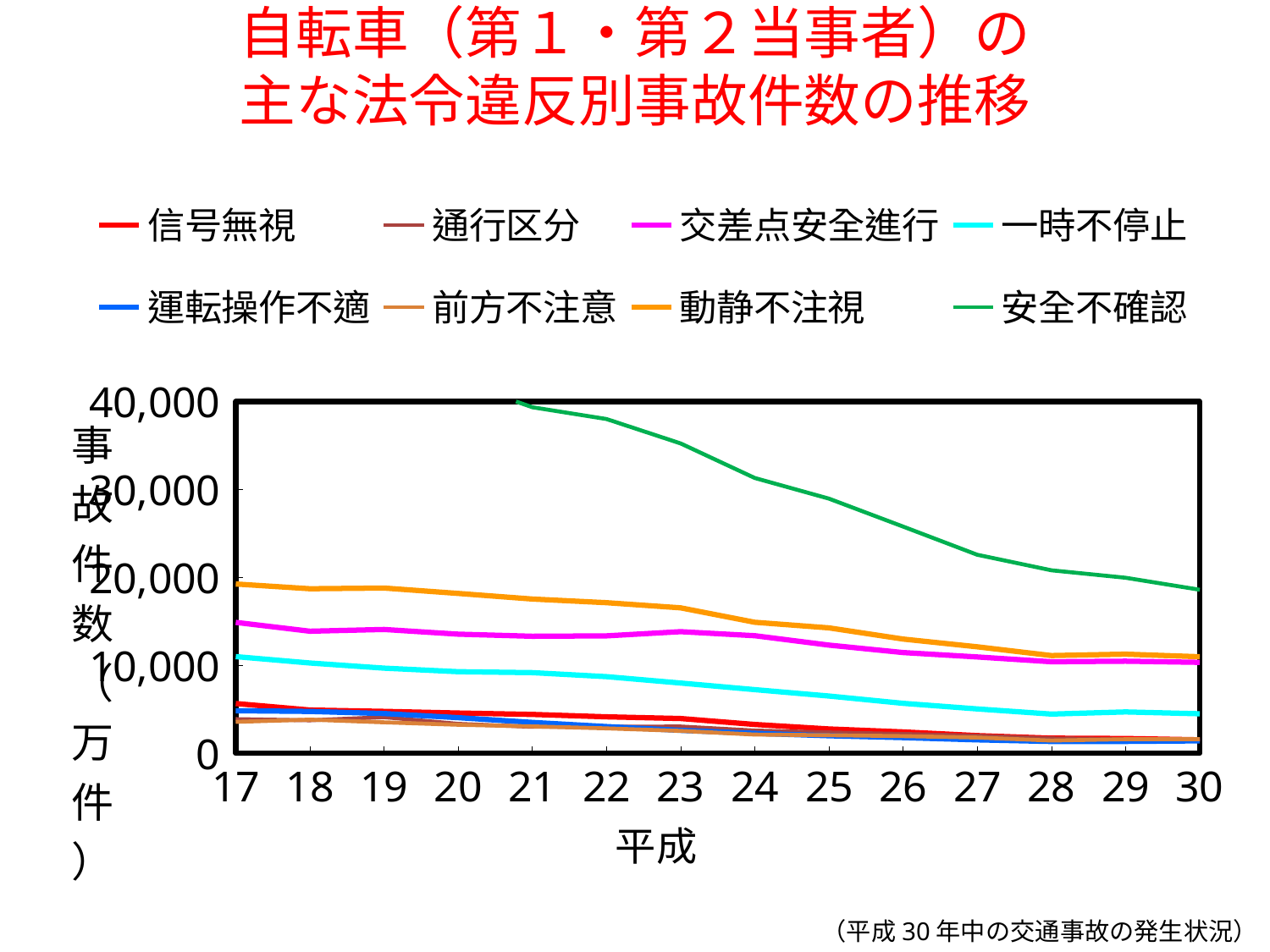
What kind of chart is shown on the slide? line chart How many years (平成) are shown along the x axis? 14 Is the value for 一時不停止 at 平成30 greater or less than 10,000? less Does the 一時不停止 line rise or fall from 平成17 to 平成30? fall Does the 安全不確認 line rise or fall from 平成21 to 平成30? fall Is the value for 交差点安全進行 at 平成17 greater or less than 10,000? greater Which series has the highest value at 平成30? 安全不確認 Is the value for 安全不確認 at 平成25 greater or less than 20,000? greater What colour is the 安全不確認 line in the legend? green How many series does the legend list? 8 At 平成20, which is larger: 動静不注視 or 一時不停止? 動静不注視 Which series has the highest value at 平成17? 安全不確認